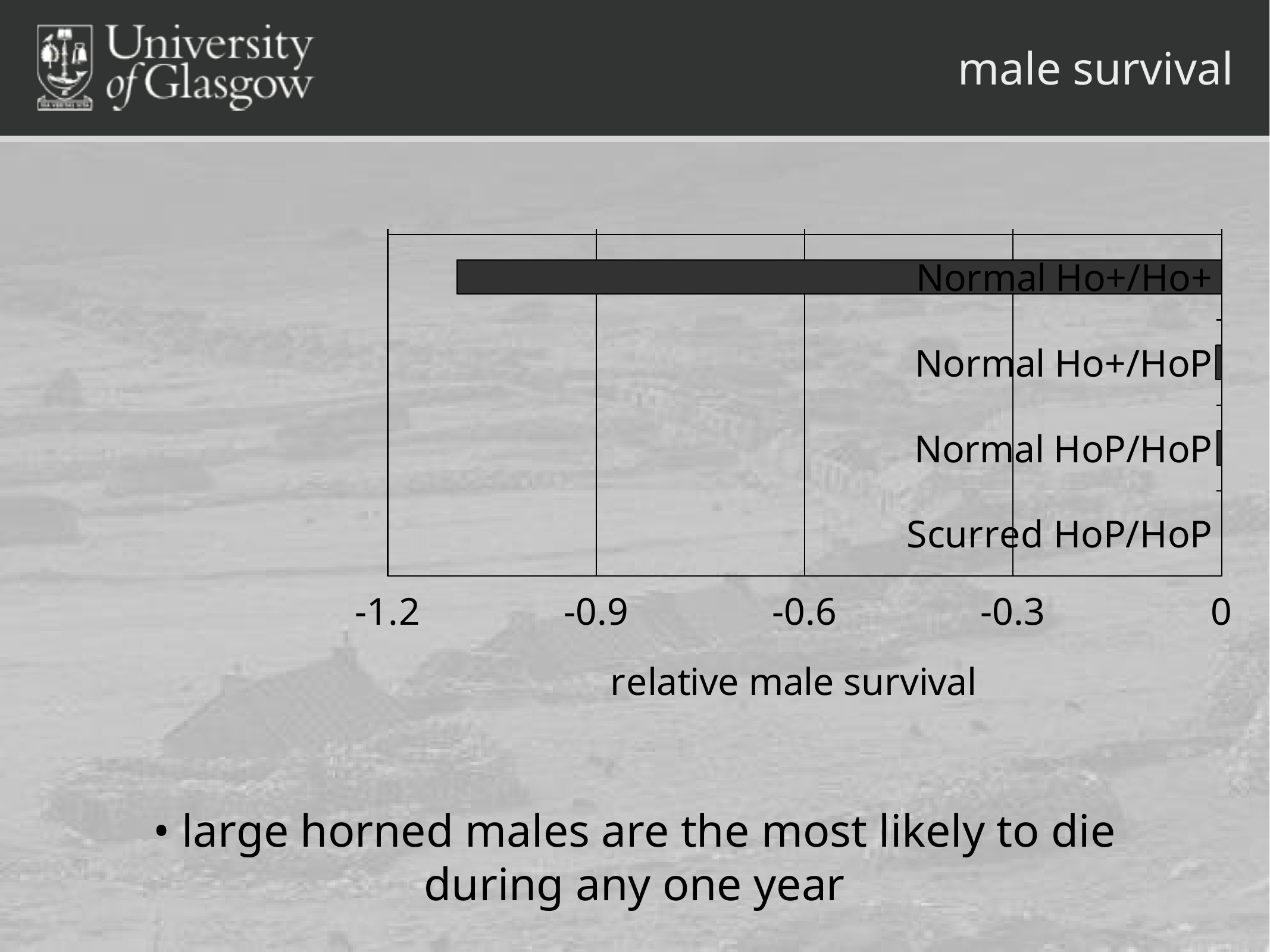
Is the value for Normal Ho+/HoP greater or less than -0.3? greater Is the value for Normal HoP/HoP greater or less than -0.3? greater Is the value for Normal Ho+/Ho+ greater or less than -0.6? less What is the label of the x axis? relative male survival Which category has the lowest (most negative) relative male survival? Normal Ho+/Ho+ Which has the larger relative male survival, Normal Ho+/Ho+ or Normal Ho+/HoP? Normal Ho+/HoP What is the title of the slide containing the chart? male survival What kind of chart is shown on the slide? bar chart Which has the larger relative male survival, Normal Ho+/Ho+ or Normal HoP/HoP? Normal HoP/HoP How many categories are plotted in the chart? 4